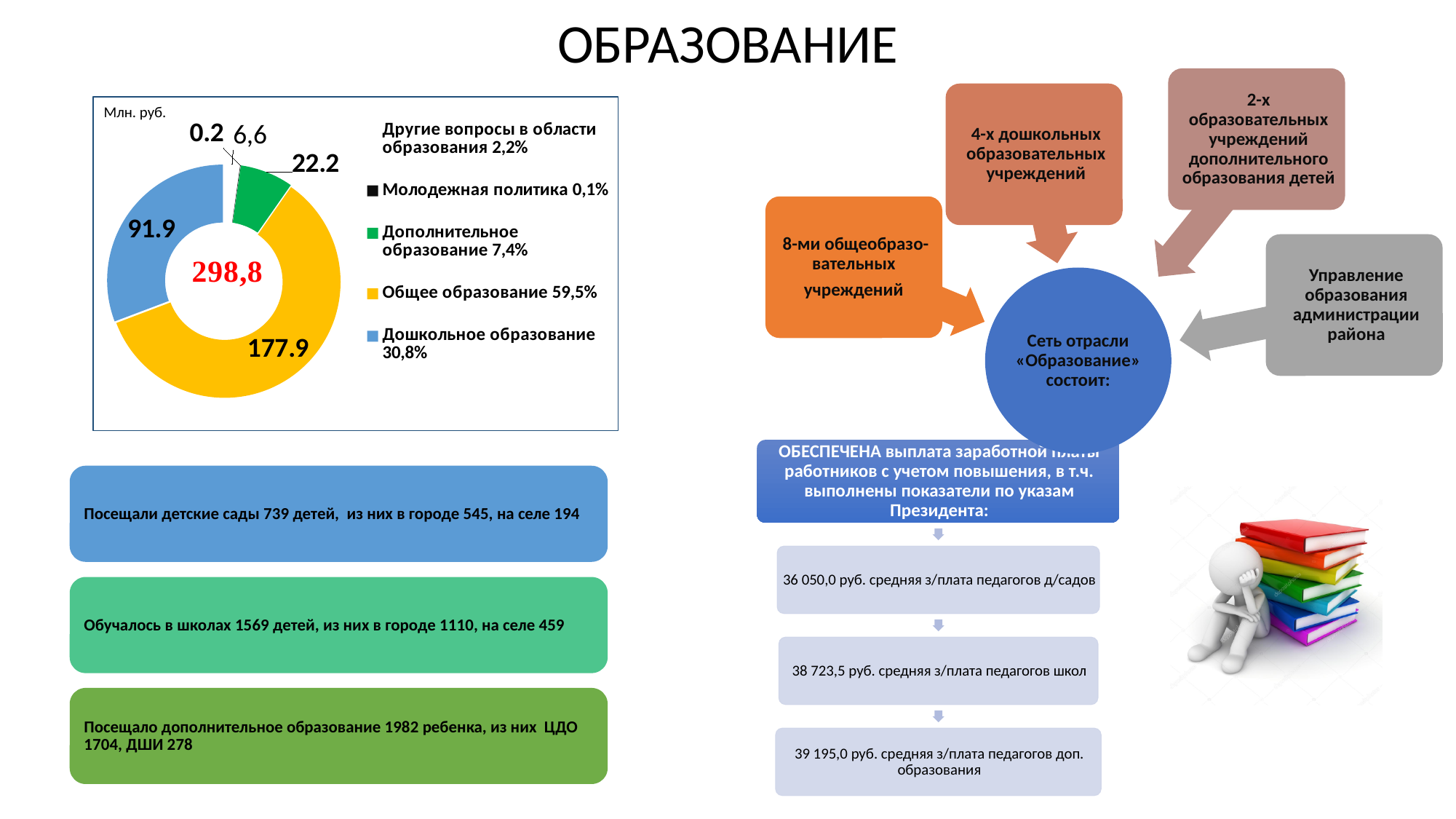
What total value is printed in the centre of the doughnut chart? 298,8 Which category has the smallest value in the doughnut chart? Молодежная политика What value is shown for Общее образование in the doughnut chart? 177.9 What value is shown for Дополнительное образование in the doughnut chart? 22.2 What value is shown for Молодежная политика in the doughnut chart? 0.2 Which is larger in the doughnut chart: Дошкольное образование or Дополнительное образование? Дошкольное образование What share of the doughnut chart does Общее образование represent, according to the legend? 59,5% What is the difference between the values for Общее образование and Дошкольное образование in the doughnut chart? 86.0 Which category has the largest value in the doughnut chart? Общее образование How many categories does the legend of the doughnut chart list? 5 What value is shown for Дошкольное образование in the doughnut chart? 91.9 What kind of chart is shown on the left of the slide? Doughnut (pie) chart